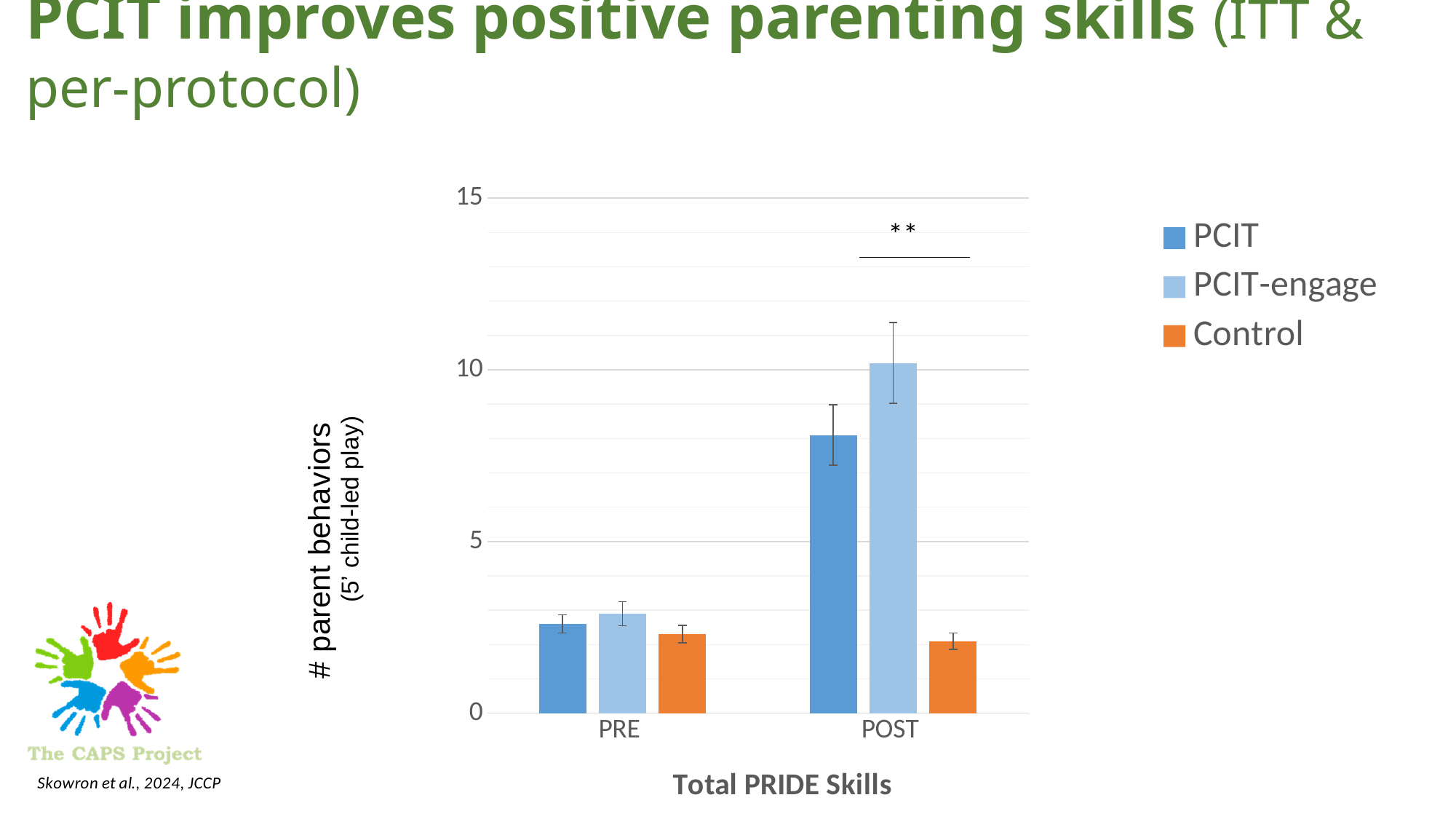
Is the value for PCIT at POST greater or less than 10? less Is the value for Control at POST greater or less than 5? less How many categories are shown on the x axis? 2 Which is larger for PCIT: the PRE value or the POST value? POST Do the values for PCIT-engage rise or fall from PRE to POST? rise Which series has the lowest value at POST? Control How many series does the legend list? 3 Is the value for PCIT-engage at PRE greater or less than 5? less What is the x-axis title of the chart? Total PRIDE Skills Which series has the highest value at POST? PCIT-engage What kind of chart is shown on the slide? bar chart